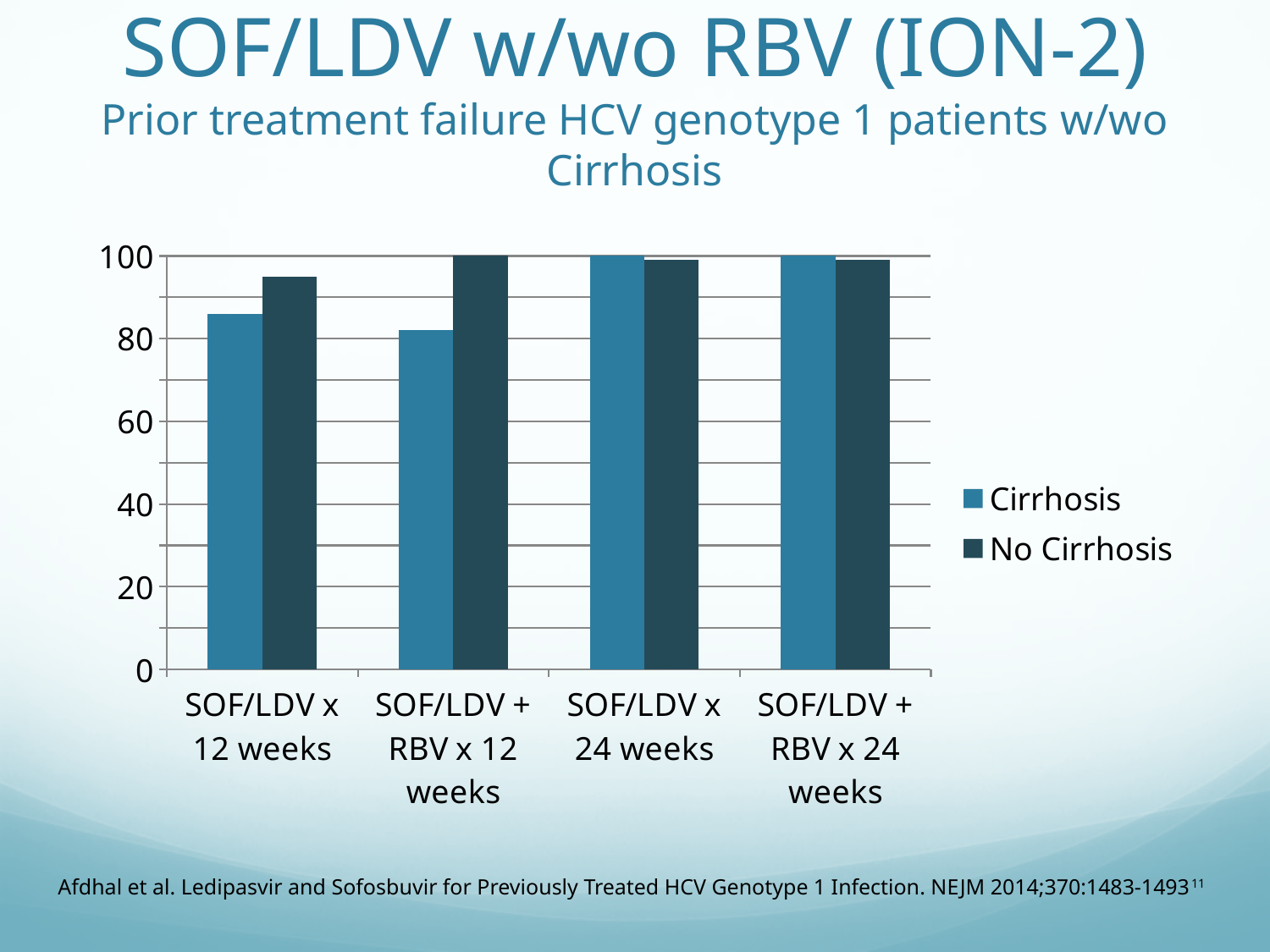
How many treatment regimen categories are shown on the x axis? 4 What kind of chart is shown on the slide? bar chart Which category has the lowest No Cirrhosis value? SOF/LDV x 12 weeks How many series does the legend list? 2 What are the two series named in the legend? Cirrhosis and No Cirrhosis For SOF/LDV x 12 weeks, which is larger: the Cirrhosis value or the No Cirrhosis value? No Cirrhosis Which category has the lowest Cirrhosis value? SOF/LDV + RBV x 12 weeks Is the Cirrhosis value for SOF/LDV x 12 weeks greater or less than 60? greater Is the Cirrhosis value for SOF/LDV + RBV x 12 weeks greater or less than 100? less Is the Cirrhosis value for SOF/LDV x 12 weeks greater or less than 80? greater For SOF/LDV + RBV x 12 weeks, which is larger: the Cirrhosis value or the No Cirrhosis value? No Cirrhosis